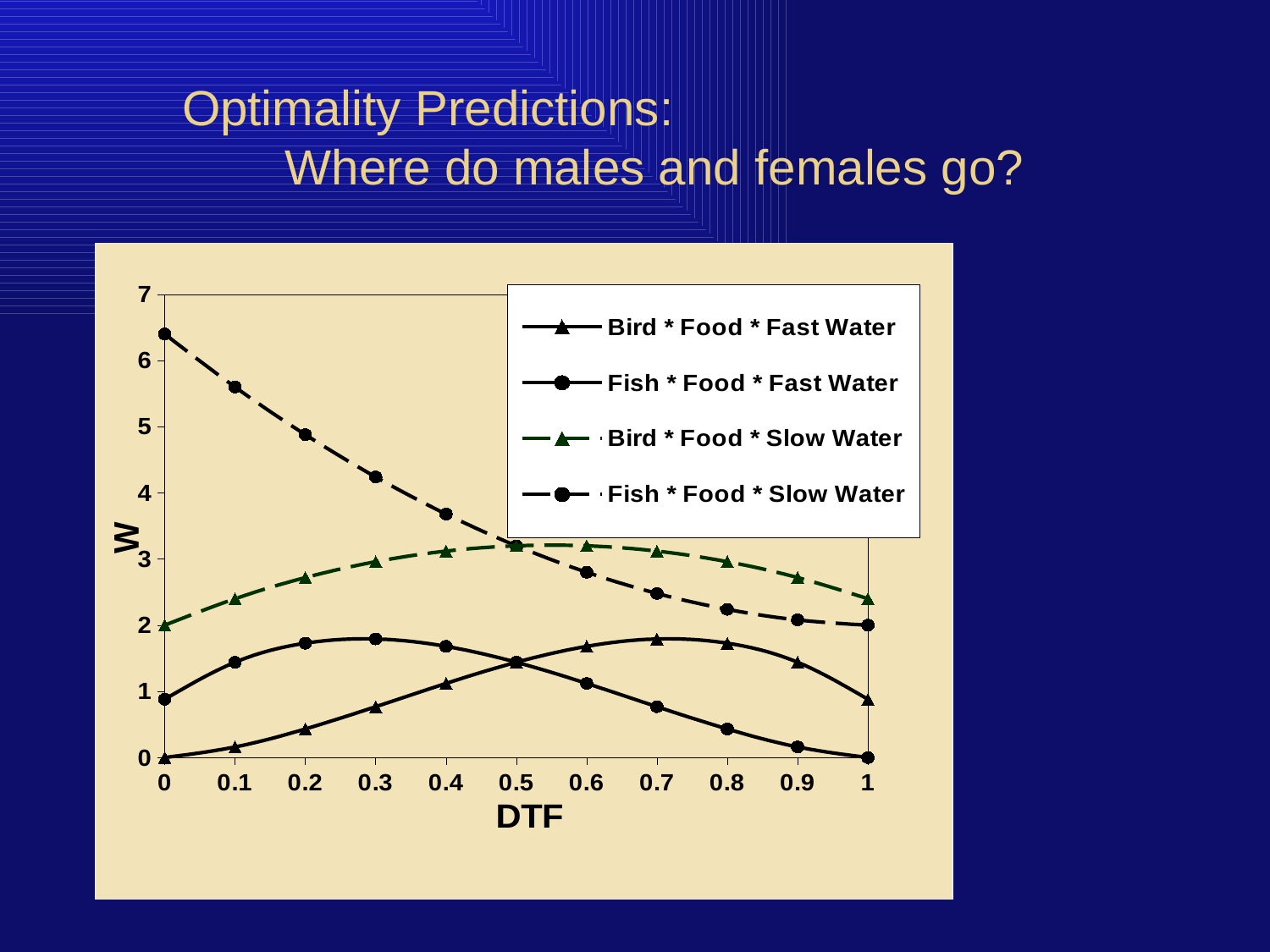
What is the value of W for Bird * Food * Fast Water at DTF 0? 0 What kind of chart is shown on the slide? line chart What is the value of W for Bird * Food * Slow Water at DTF 0? 2 How many series does the legend list? 4 How many DTF values are plotted along the x axis? 11 Which series has the lowest W at DTF 1? Fish * Food * Fast Water What is the value of W for Fish * Food * Fast Water at DTF 1? 0 Is the value of W for Fish * Food * Slow Water at DTF 0 greater or less than 6? greater At DTF 1, which series has the larger W: Bird * Food * Slow Water or Fish * Food * Slow Water? Bird * Food * Slow Water Which series has the highest W at DTF 0? Fish * Food * Slow Water Does the W value for Fish * Food * Slow Water rise or fall as DTF increases from 0 to 1? fall Is the value of W for Fish * Food * Fast Water at DTF 0.3 greater or less than 2? less